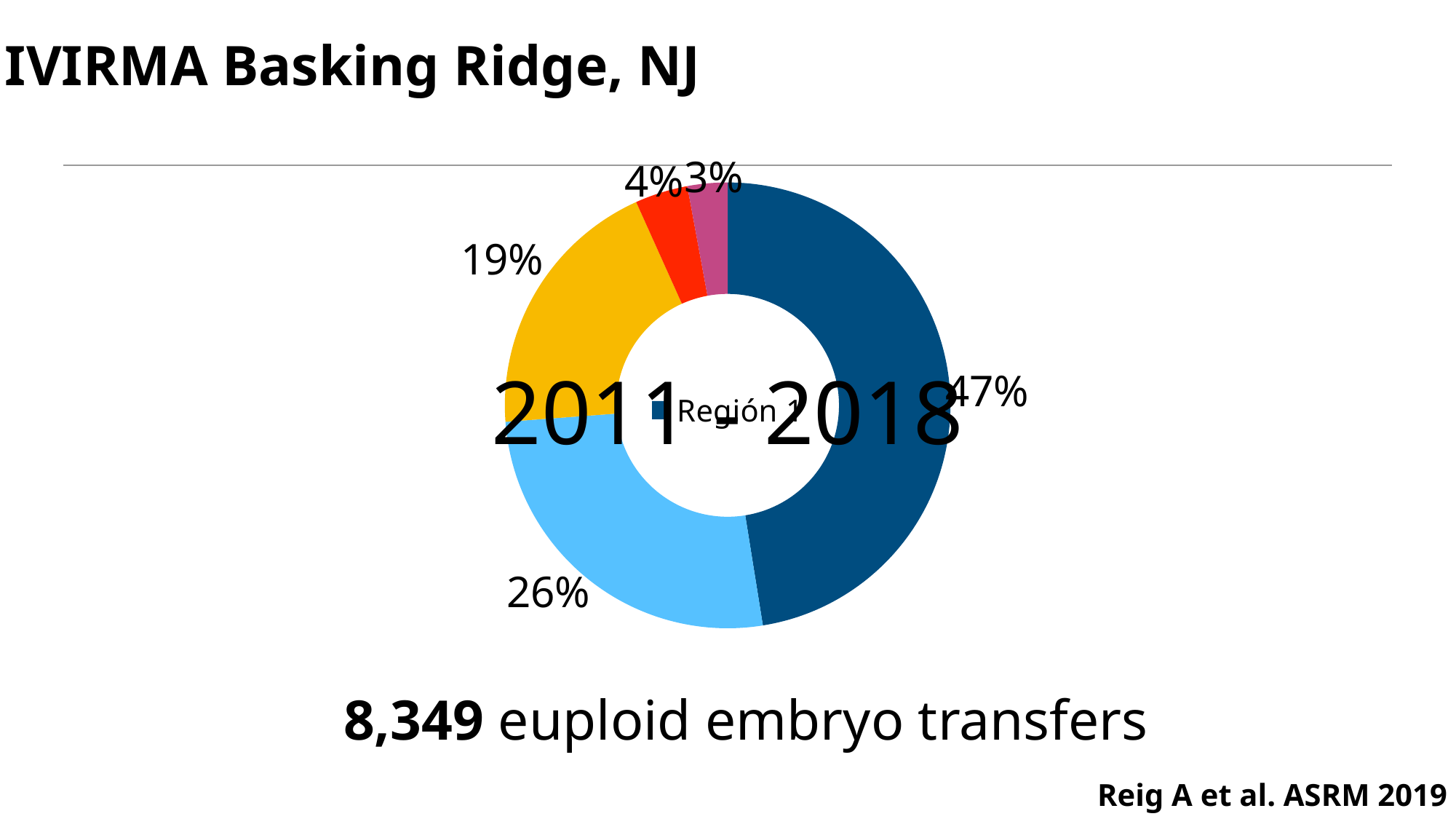
What kind of chart is shown on the slide? Doughnut chart How many slices does the doughnut chart have? 5 What percentage is shown for the red slice of the doughnut chart? 4% What percentage is shown for the magenta slice of the doughnut chart? 3% Which is larger, the yellow slice or the light blue slice? The light blue slice What percentage is shown for the light blue slice of the doughnut chart? 26% Which slice of the doughnut chart has the smallest share? The magenta slice (3%) Which slice of the doughnut chart has the largest share? The dark blue slice (47%) What percentage is shown for the dark blue slice of the doughnut chart? 47% What percentage is shown for the yellow slice of the doughnut chart? 19% What is the difference in percentage points between the dark blue slice and the light blue slice? 21 percentage points What is the title of the slide containing the doughnut chart? IVIRMA Basking Ridge, NJ